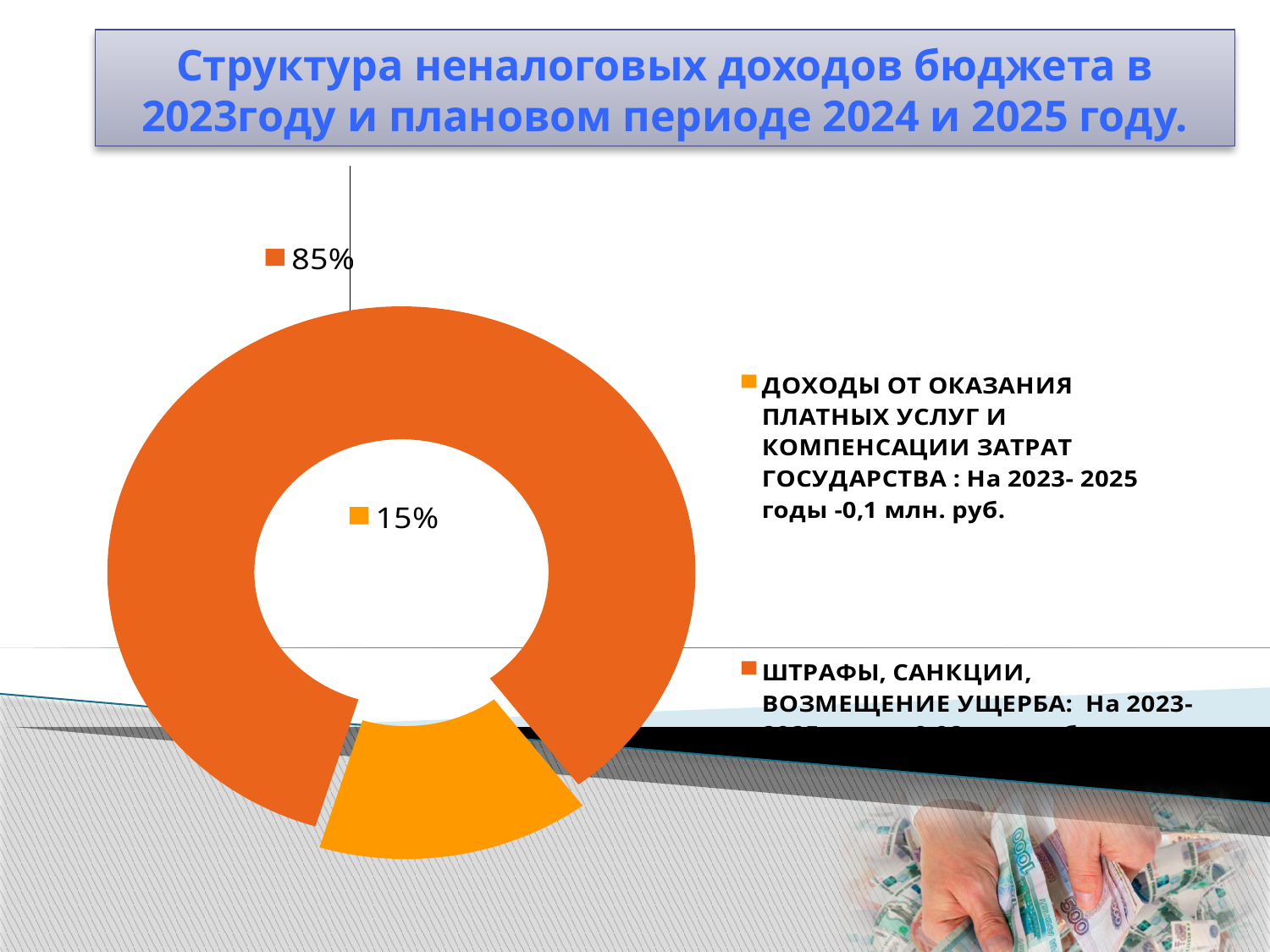
How many slices does the doughnut chart have? 2 Which category has the smallest share of the doughnut chart? ДОХОДЫ ОТ ОКАЗАНИЯ ПЛАТНЫХ УСЛУГ И КОМПЕНСАЦИИ ЗАТРАТ ГОСУДАРСТВА Which is larger: the share for ШТРАФЫ, САНКЦИИ, ВОЗМЕЩЕНИЕ УЩЕРБА or the share for ДОХОДЫ ОТ ОКАЗАНИЯ ПЛАТНЫХ УСЛУГ? ШТРАФЫ, САНКЦИИ, ВОЗМЕЩЕНИЕ УЩЕРБА By how many percentage points does the larger slice exceed the smaller slice? 70 percentage points What share of the doughnut chart is labelled for ДОХОДЫ ОТ ОКАЗАНИЯ ПЛАТНЫХ УСЛУГ И КОМПЕНСАЦИИ ЗАТРАТ ГОСУДАРСТВА? 15% Which category has the largest share of the doughnut chart? ШТРАФЫ, САНКЦИИ, ВОЗМЕЩЕНИЕ УЩЕРБА How many entries does the legend list? 2 What is the share of the light orange slice? 15% What share of the doughnut chart is labelled for ШТРАФЫ, САНКЦИИ, ВОЗМЕЩЕНИЕ УЩЕРБА? 85% What kind of chart is shown on the slide? Doughnut (pie) chart What amount in млн. руб. is given in the legend for ДОХОДЫ ОТ ОКАЗАНИЯ ПЛАТНЫХ УСЛУГ И КОМПЕНСАЦИИ ЗАТРАТ ГОСУДАРСТВА for 2023-2025? 0,1 млн. руб. What is the title of the slide? Структура неналоговых доходов бюджета в 2023году и плановом периоде 2024 и 2025 году.